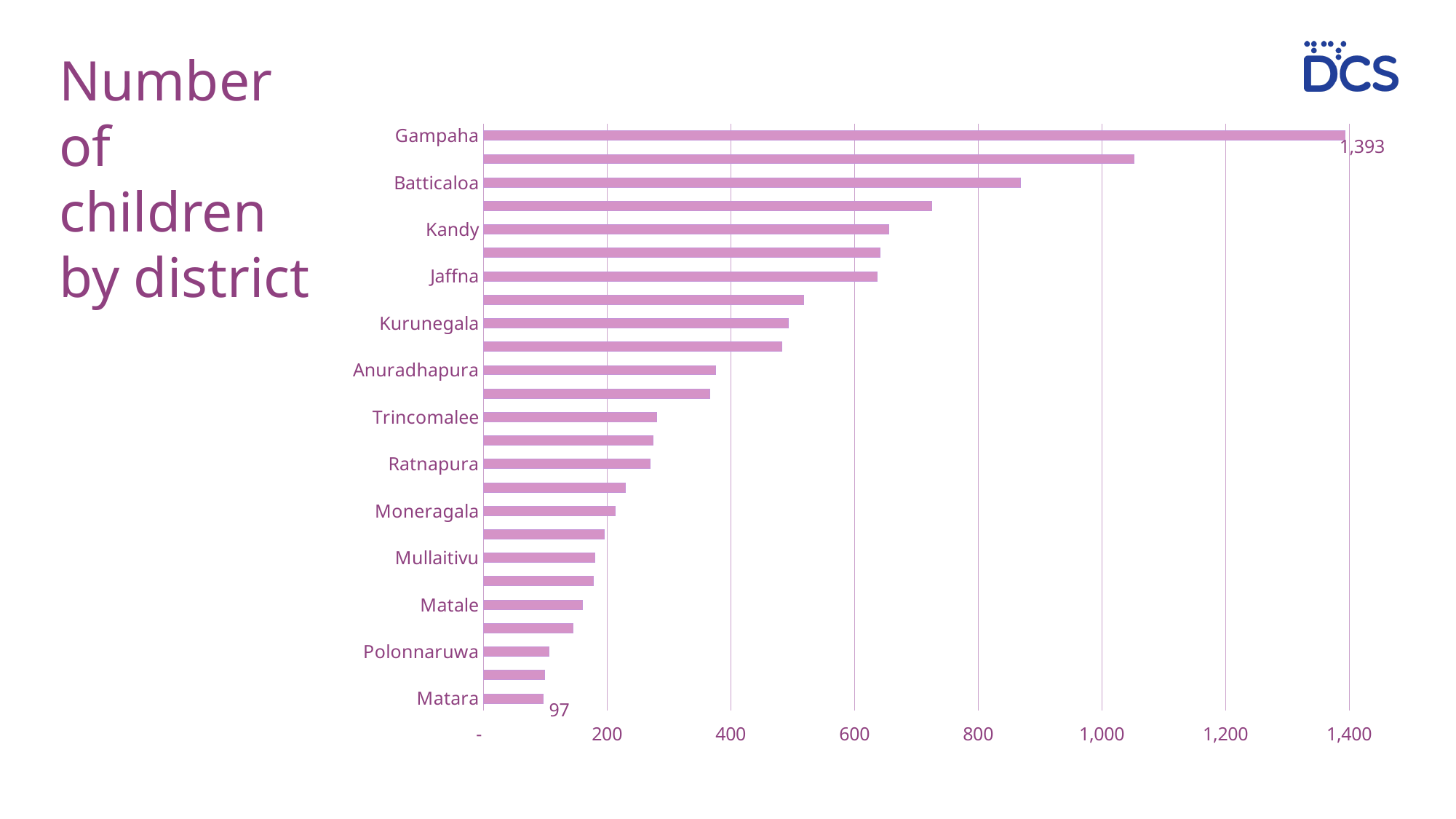
What is the number of children for Matara? 97 What kind of chart is shown on the slide? Bar chart Which district has the lowest number of children? Matara Which district has more children, Batticaloa or Kandy? Batticaloa Is the value for Mullaitivu greater or less than 200? less Is the value for Batticaloa greater or less than 800? greater Which district has the highest number of children? Gampaha Is the value for Anuradhapura greater or less than 400? less What is the title of the chart on the slide? Number of children by district What is the number of children for Gampaha? 1,393 What is the difference between the number of children in Gampaha and Matara? 1,296 How many bars are plotted in the chart? 25